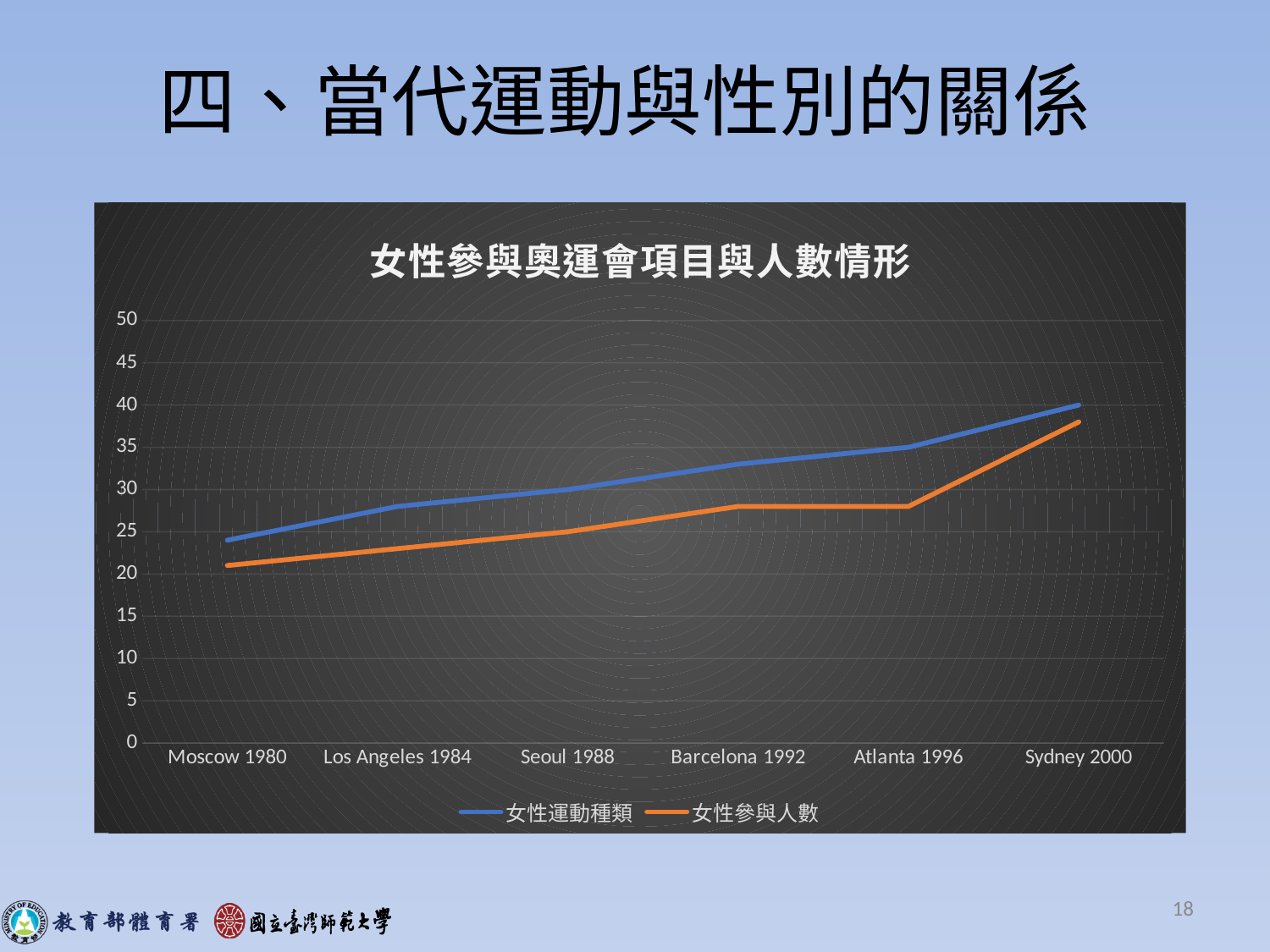
What is the title of the chart? 女性參與奧運會項目與人數情形 Is the value of 女性參與人數 at Sydney 2000 greater or less than 35? greater At which Olympic Games is 女性運動種類 highest? Sydney 2000 What is the value of 女性運動種類 at Sydney 2000? 40 What kind of chart is shown on the slide? line chart How many series does the legend list? 2 Is the value of 女性運動種類 at Moscow 1980 greater or less than 20? greater How many Olympic Games (categories) are shown on the x axis? 6 Is the value of 女性參與人數 at Moscow 1980 greater or less than 25? less What is the value of 女性運動種類 at Atlanta 1996? 35 At which Olympic Games is 女性參與人數 lowest? Moscow 1980 Which series is drawn in orange? 女性參與人數